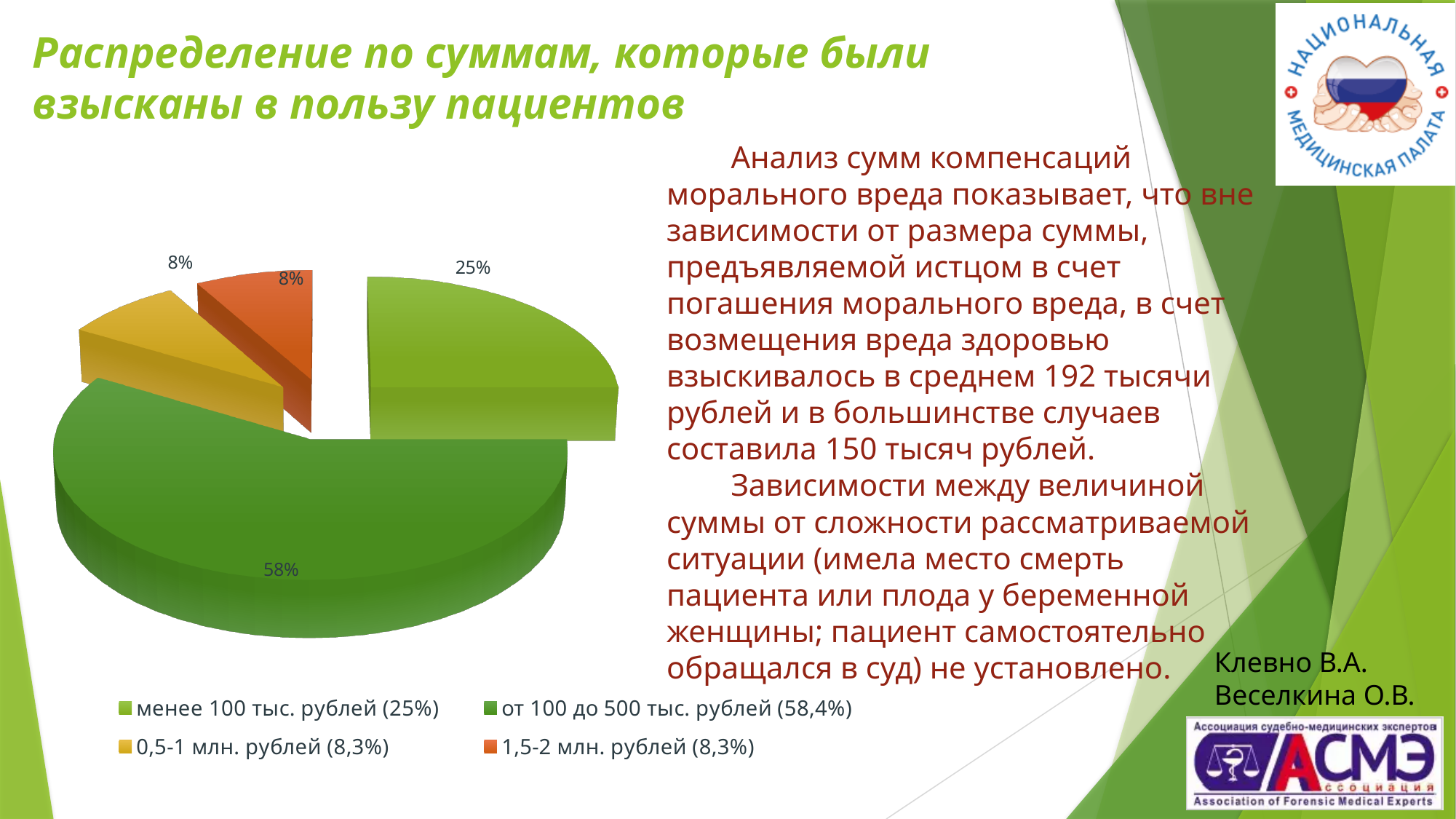
What data label is shown on the slice for 'от 100 до 500 тыс. рублей'? 58% How many slices does the pie chart have? 4 Which is larger: the share for 'менее 100 тыс. рублей' or the share for '0,5-1 млн. рублей'? менее 100 тыс. рублей What kind of chart is shown on the slide? pie chart Which category has the largest share of the pie? от 100 до 500 тыс. рублей How many entries does the legend list? 4 According to the legend, what percentage is given for 'от 100 до 500 тыс. рублей'? 58,4% What data label is shown on the slice for 'менее 100 тыс. рублей'? 25% What colour is the slice for '1,5-2 млн. рублей'? orange What data label is shown on the slice for '1,5-2 млн. рублей'? 8% What data label is shown on the slice for '0,5-1 млн. рублей'? 8% By how many percentage points does the data label for 'от 100 до 500 тыс. рублей' exceed the data label for 'менее 100 тыс. рублей'? 33%